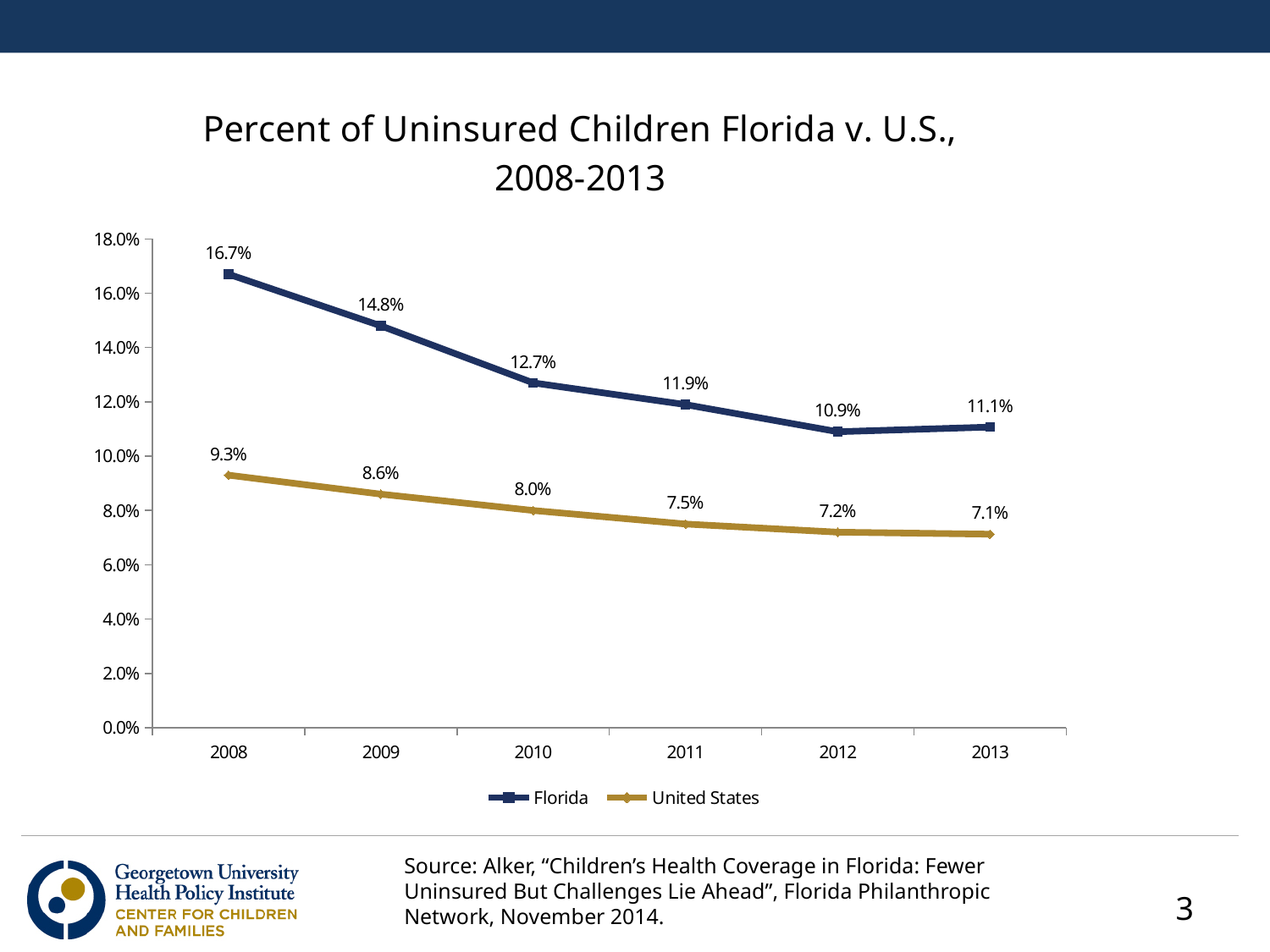
What is the difference between the Florida and United States values in 2010? 4.7% What was the percent of uninsured children in Florida in 2008? 16.7% What kind of chart is shown on the slide? Line chart What was the percent of uninsured children in Florida in 2011? 11.9% In which year was the Florida percent of uninsured children lowest? 2012 By how much did the Florida percent of uninsured children fall from 2008 to 2013? 5.6% How many series does the legend list? 2 Is the Florida value for 2009 greater or less than 14.0%? greater Which series had the higher value in 2012, Florida or United States? Florida What was the percent of uninsured children in the United States in 2013? 7.1% In which year was the United States percent of uninsured children highest? 2008 How many years are shown on the x axis? 6